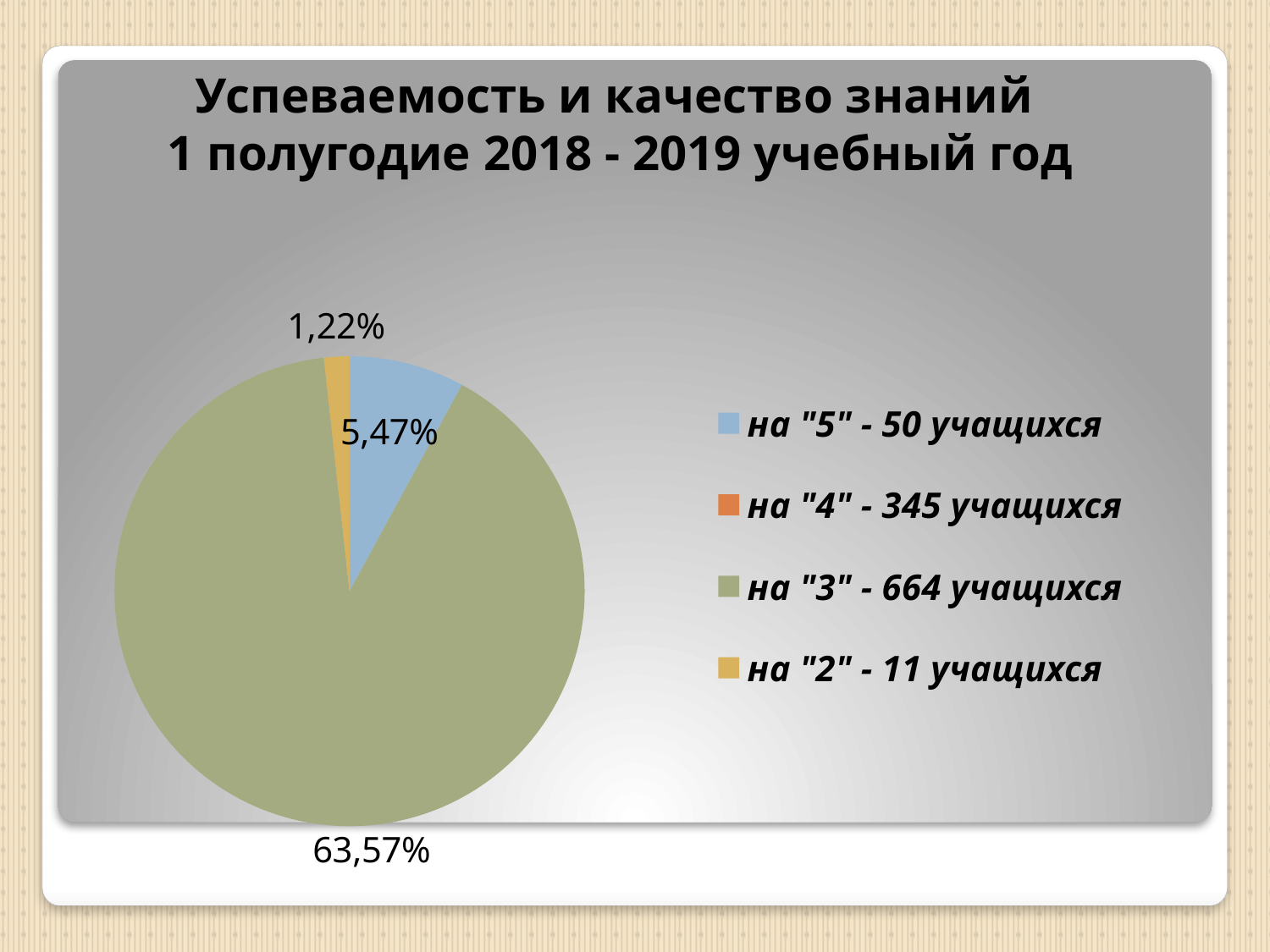
What is the difference between the printed percentages for на "5" and на "2"? 4,25% According to the legend, how many students received "3"? 664 учащихся What kind of chart is shown on the slide? pie chart What percentage is printed for the slice for на "5"? 5,47% What is the title of the chart on the slide? Успеваемость и качество знаний 1 полугодие 2018 - 2019 учебный год Which category has the smallest printed percentage on the pie? на "2" Which category has the largest slice of the pie? на "3" How many entries does the legend of the pie chart list? 4 According to the legend, how many students received "4"? 345 учащихся Which slice is larger, на "5" or на "2"? на "5" What percentage is printed for the slice for на "2"? 1,22% What percentage is printed for the slice for на "3"? 63,57%